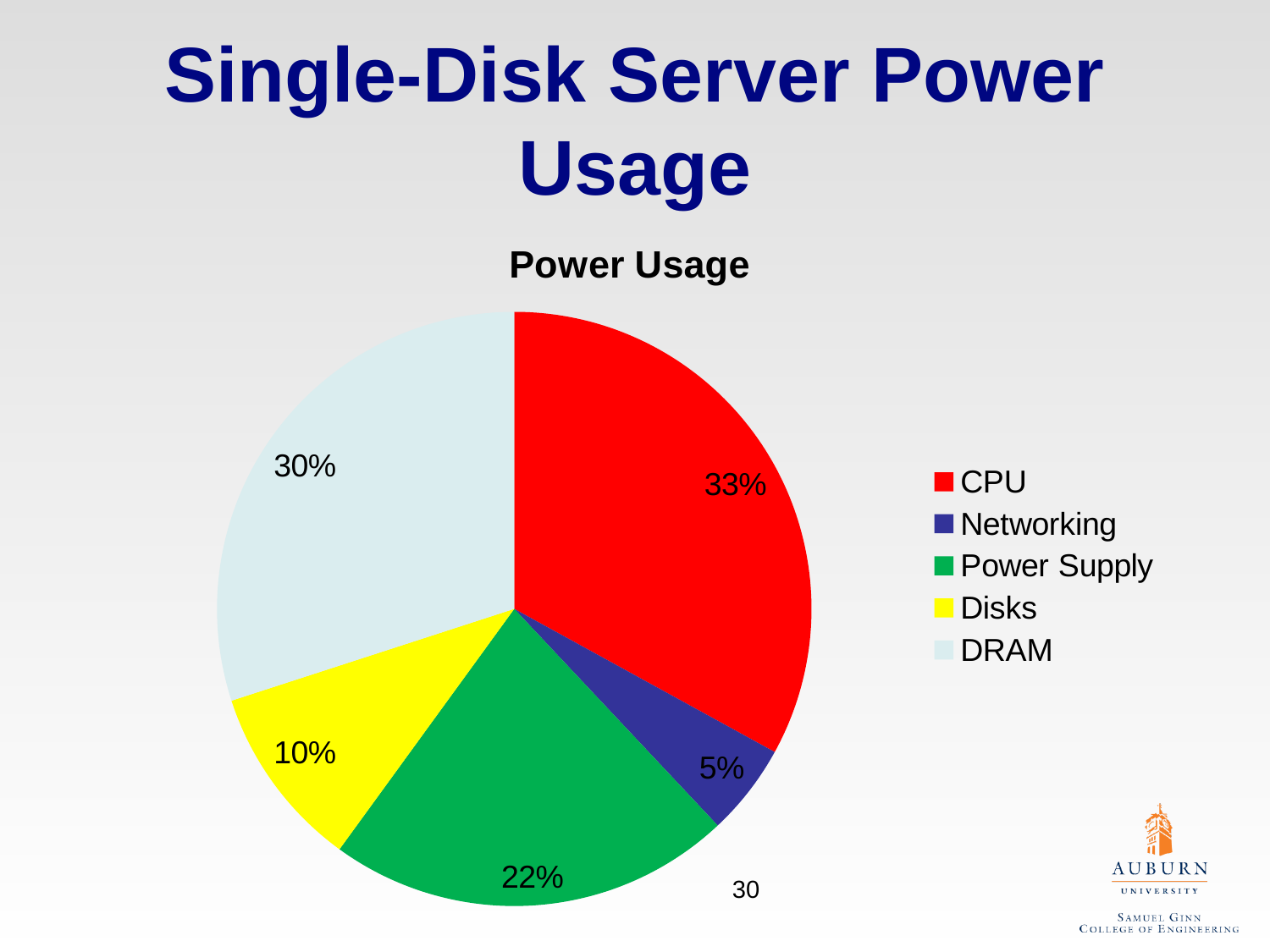
What is the difference between the CPU share and the DRAM share? 3% Which component has the largest share of power usage? CPU Which has a larger share of power usage, Power Supply or Disks? Power Supply How many categories does the legend list? 5 What share of power usage does DRAM account for? 30% What share of power usage do Disks account for? 10% What share of power usage does the CPU account for? 33% What is the chart's title? Power Usage What type of chart is shown on the slide? pie chart Which component has the smallest share of power usage? Networking